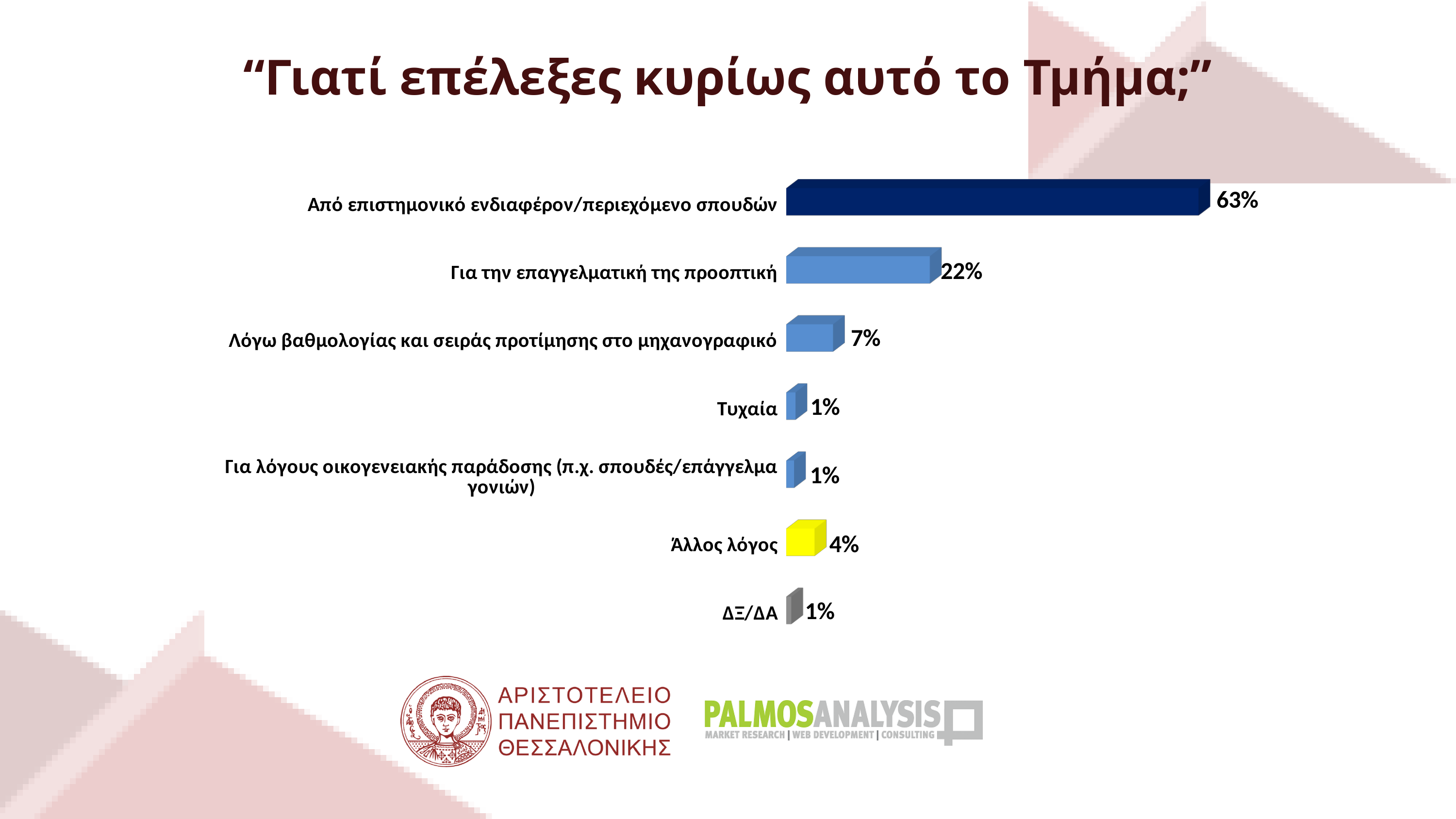
What is the value for "Άλλος λόγος"? 4% What is the value for "ΔΞ/ΔΑ"? 1% What kind of chart is shown on the slide? Bar chart What is the value for "Για την επαγγελματική της προοπτική"? 22% How many categories are shown in the chart? 7 What is the difference between the values for "Από επιστημονικό ενδιαφέρον/περιεχόμενο σπουδών" and "Για την επαγγελματική της προοπτική"? 41% Which is larger, the value for "Άλλος λόγος" or the value for "Τυχαία"? Άλλος λόγος Which category has the highest value? Από επιστημονικό ενδιαφέρον/περιεχόμενο σπουδών What is the value for "Λόγω βαθμολογίας και σειράς προτίμησης στο μηχανογραφικό"? 7% What colour is the bar for "Άλλος λόγος"? Yellow What is the difference between the values for "Λόγω βαθμολογίας και σειράς προτίμησης στο μηχανογραφικό" and "Άλλος λόγος"? 3% What is the value for "Από επιστημονικό ενδιαφέρον/περιεχόμενο σπουδών"? 63%